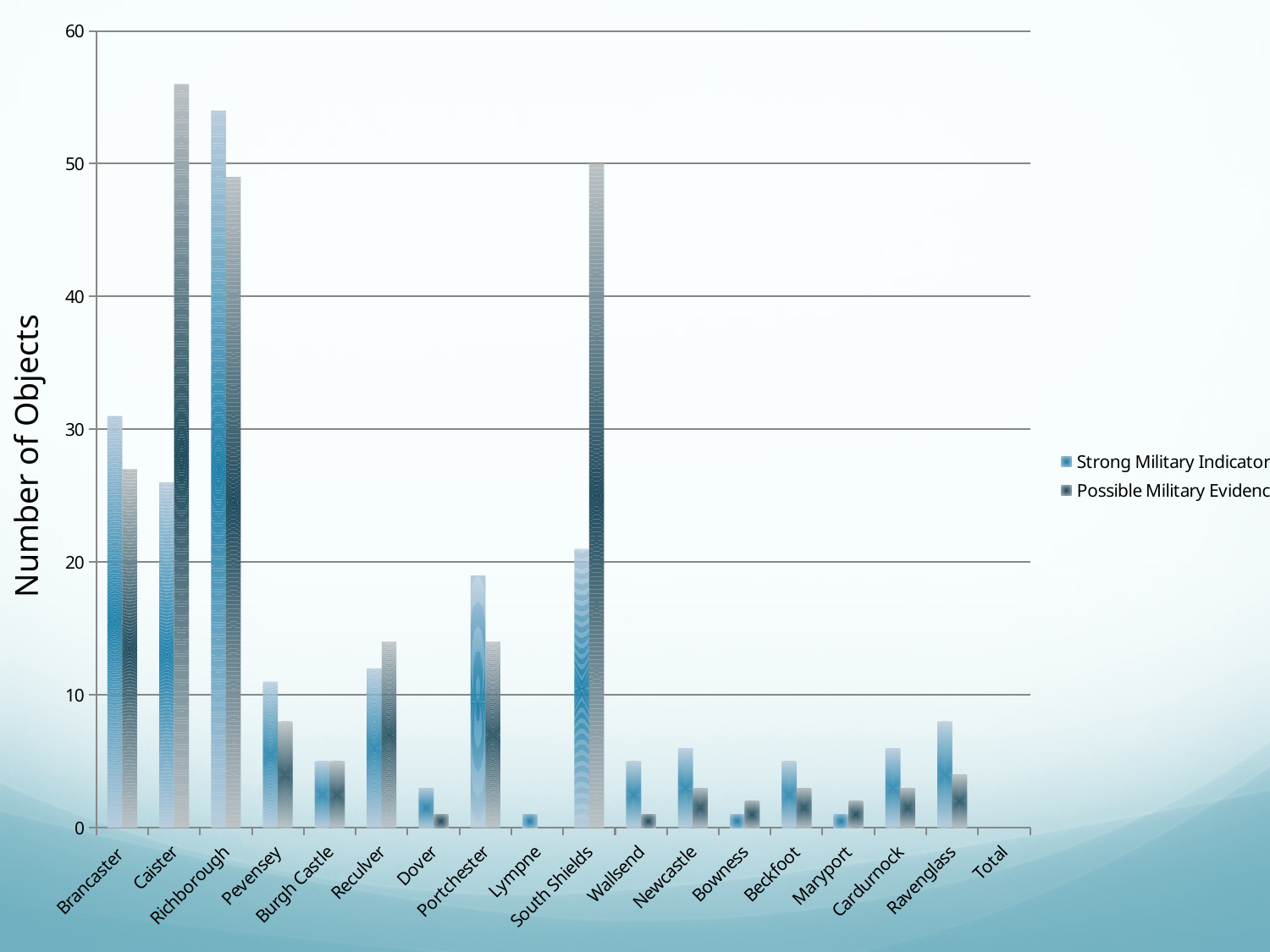
Which category has the highest value for the Possible Military Evidence series? Caister What kind of chart is shown on the slide? bar chart For Richborough, which series has the larger value: Strong Military Indicator or Possible Military Evidence? Strong Military Indicator Is the Possible Military Evidence value for Caister greater or less than 50? greater Is the Strong Military Indicator value for Dover greater or less than 10? less For Caister, which series has the larger value: Strong Military Indicator or Possible Military Evidence? Possible Military Evidence Which category has the highest value for the Strong Military Indicator series? Richborough Is the Strong Military Indicator value for Richborough greater or less than 50? greater What is the title of the vertical axis? Number of Objects How many series does the legend list? 2 How many categories are shown along the x axis? 18